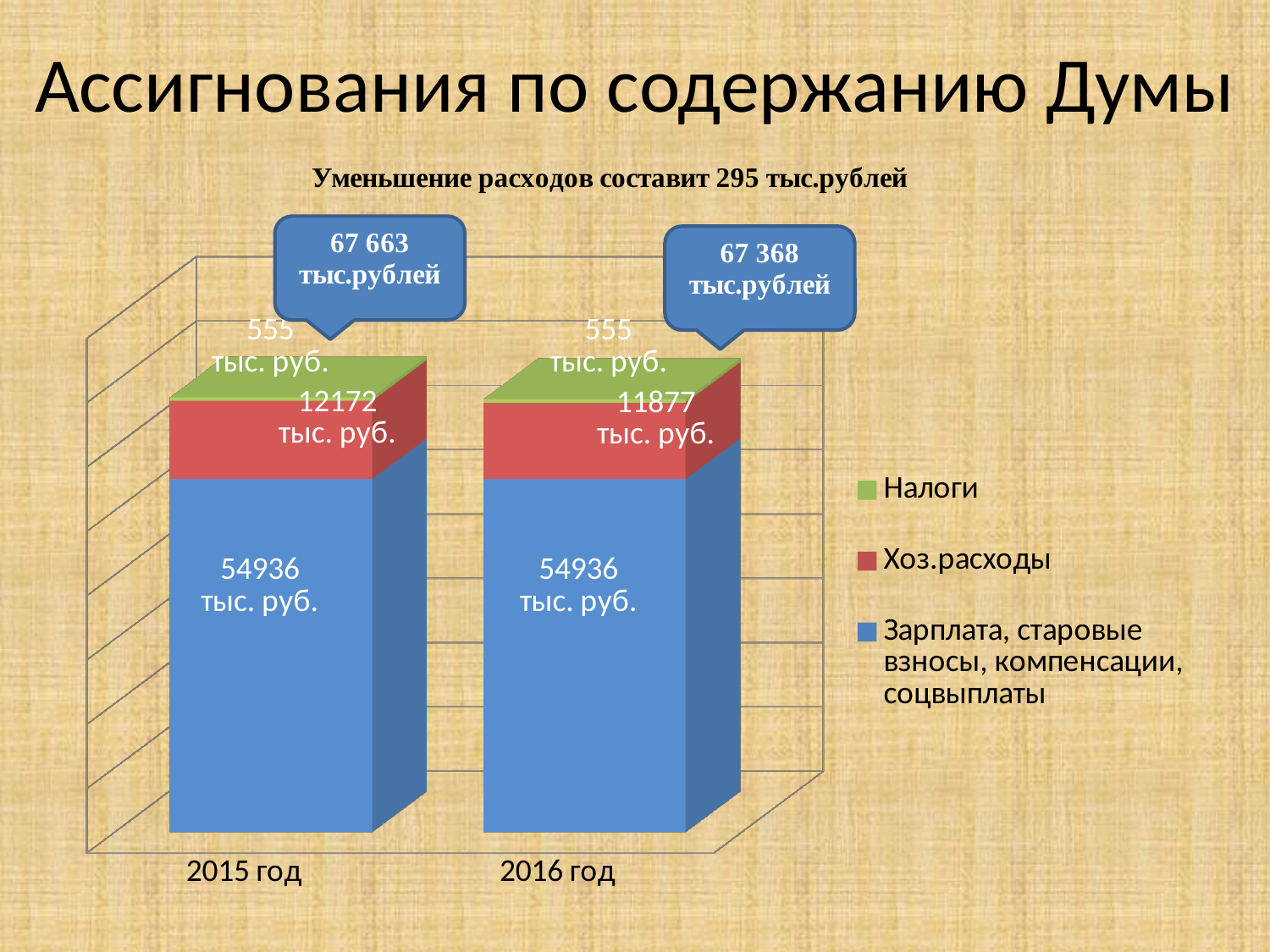
Which series is shown in green in the legend? Налоги What type of chart is shown on the slide? Stacked bar chart What is the difference between Хоз.расходы in 2015 год and 2016 год? 295 тыс. руб. How many series does the legend list? 3 Which year has the larger value for Хоз.расходы, 2015 год or 2016 год? 2015 год What is the value of Налоги for 2016 год? 555 тыс. руб. What is the value of Хоз.расходы for 2015 год? 12172 тыс. руб. What is the total of the stacked bar for 2016 год? 67 368 тыс.рублей What is the value of Зарплата, старовые взносы, компенсации, соцвыплаты for 2015 год? 54936 тыс. руб. What is the value of Хоз.расходы for 2016 год? 11877 тыс. руб. How many categories (years) are shown on the x axis? 2 What is the total of the stacked bar for 2015 год? 67 663 тыс.рублей